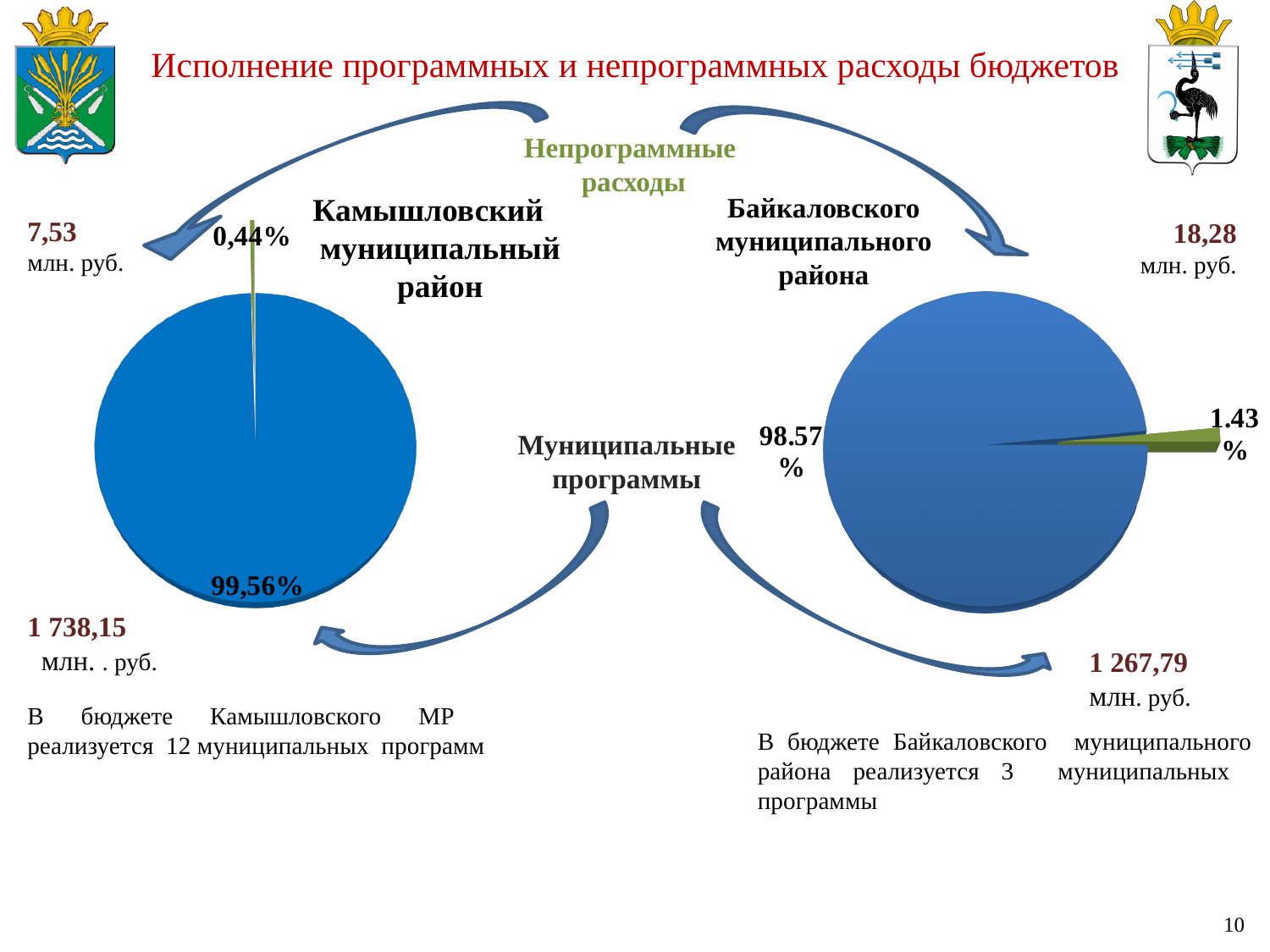
In the right pie chart (Байкаловского муниципального района), what share is labelled for Непрограммные расходы? 1.43% In the left pie chart (Камышловский муниципальный район), which slice is the largest? Муниципальные программы In the left pie chart (Камышловский муниципальный район), what share is labelled for Муниципальные программы? 99,56% How many slices does the right pie chart (Байкаловского муниципального района) have? 2 How many slices does the left pie chart (Камышловский муниципальный район) have? 2 Which district has the larger share of Непрограммные расходы: Камышловский муниципальный район (left chart) or Байкаловского муниципального района (right chart)? Байкаловского муниципального района What amount in млн. руб. is shown for Непрограммные расходы of Камышловский муниципальный район (left chart)? 7,53 What amount in млн. руб. is shown for Муниципальные программы of Байкаловского муниципального района (right chart)? 1 267,79 In the right pie chart (Байкаловского муниципального района), which slice is the smallest? Непрограммные расходы In the left pie chart (Камышловский муниципальный район), what share is labelled for Непрограммные расходы? 0,44% What kind of chart is used for the Камышловский муниципальный район data on the left? pie chart